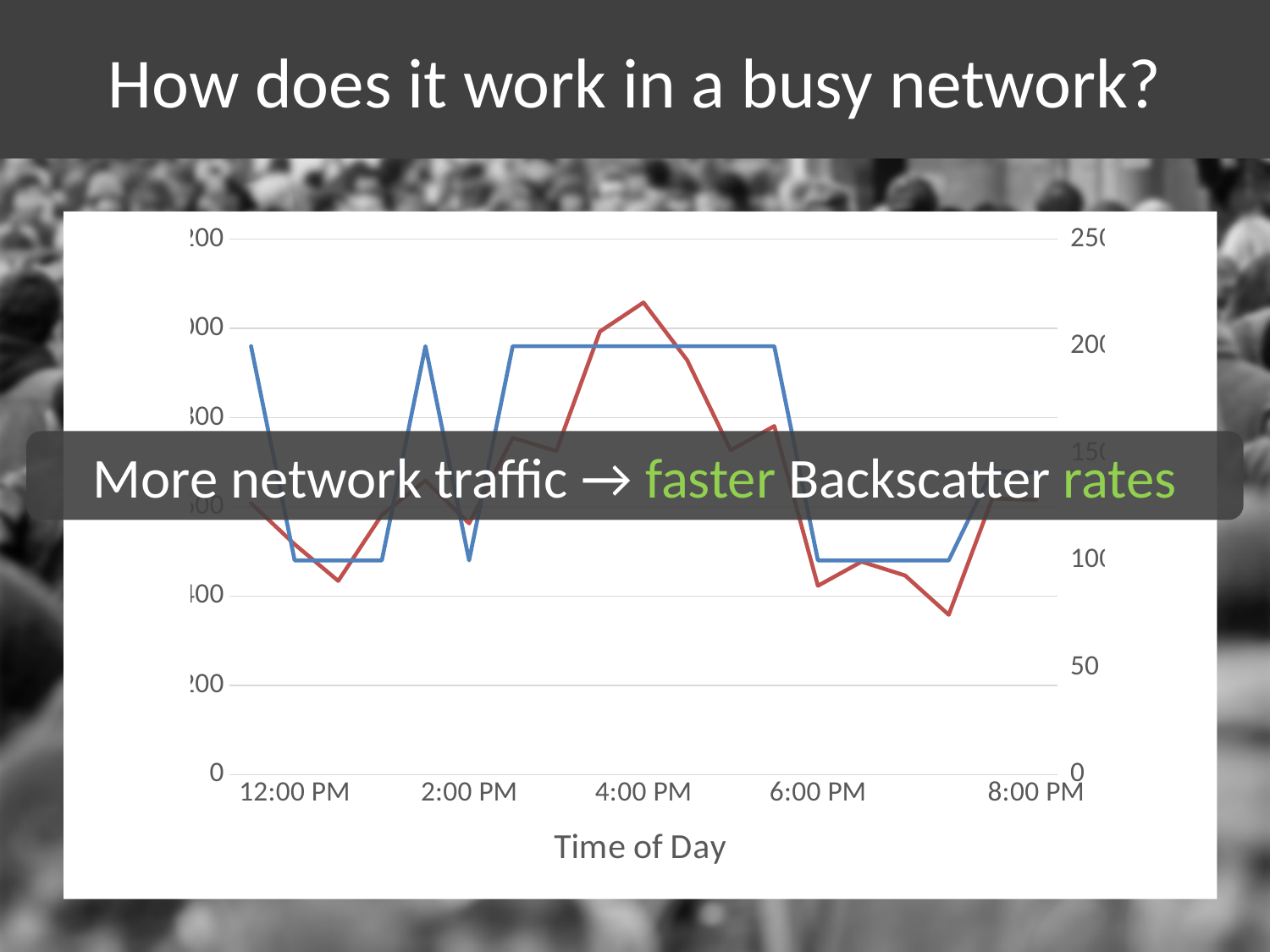
What is the title of the x axis? Time of Day How many lines are plotted on the chart? 2 At 4:00 PM, which line is plotted higher on the chart, the red line or the blue line? red line What kind of chart is shown on the slide? line chart Does the red line rise or fall between 4:00 PM and 6:00 PM? fall Between which two x-axis labels does the red line reach its lowest point? 6:00 PM and 8:00 PM How many time labels are shown along the x axis? 5 Around which x-axis time does the red line reach its highest point? 4:00 PM Does the blue line rise or fall between 2:00 PM and 4:00 PM? rise What is the first time label on the x axis? 12:00 PM